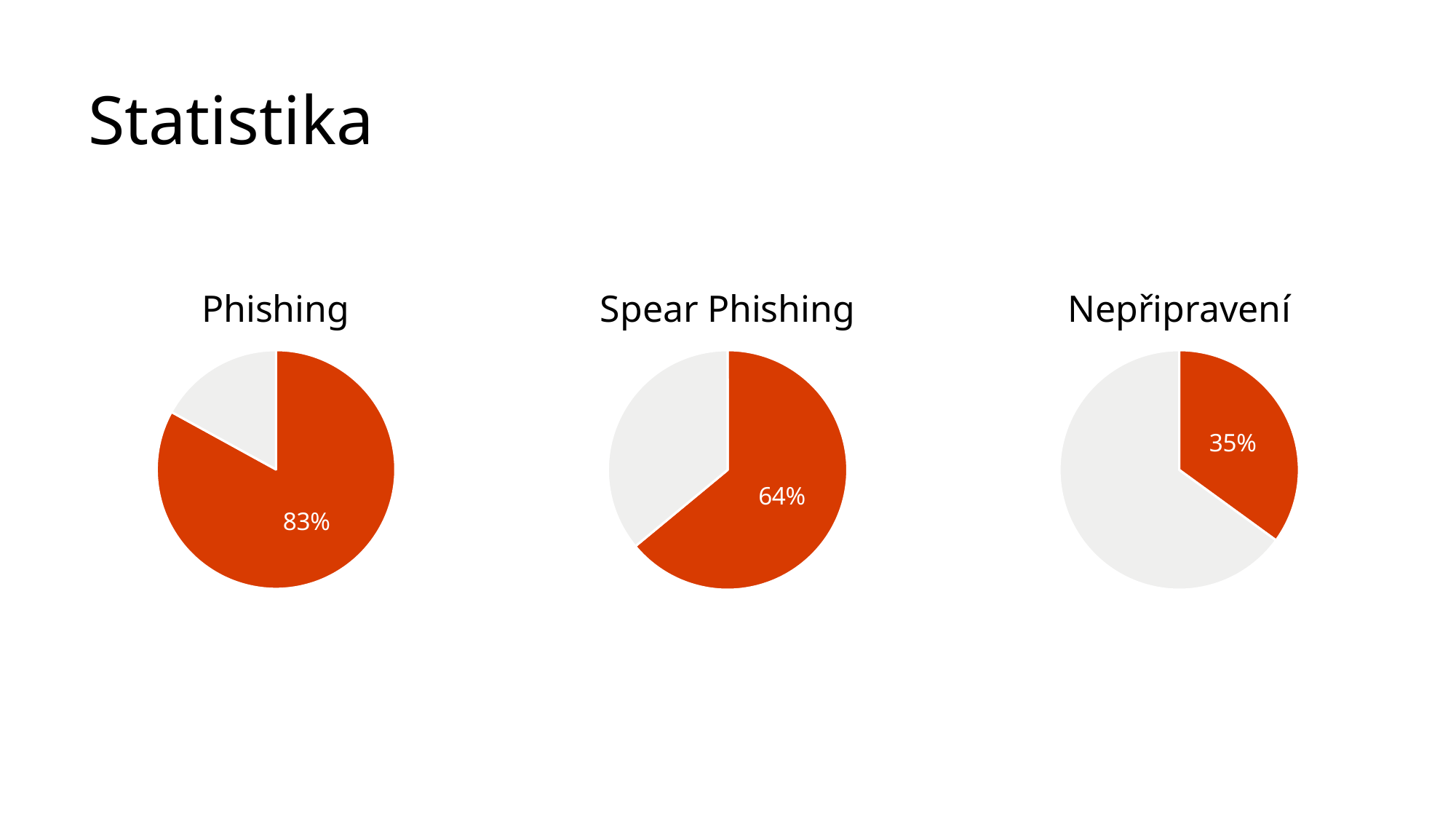
In the Spear Phishing pie chart, what percentage is shown on the orange slice? 64% Which of the three pie charts has the largest labelled orange slice? Phishing What is the difference between the labelled value in the Phishing chart and the labelled value in the Spear Phishing chart? 19% What kind of chart is the Phishing chart? pie chart What is the difference between the labelled value in the Spear Phishing chart and the labelled value in the Nepřipravení chart? 29% In the Phishing pie chart, what percentage is shown on the orange slice? 83% In the Nepřipravení pie chart, what percentage is shown on the orange slice? 35% Which of the three pie charts has the smallest labelled orange slice? Nepřipravení Is the labelled value in the Phishing chart larger or smaller than the labelled value in the Spear Phishing chart? larger How many pie charts are on the slide? 3 What is the title of the pie chart on the right of the slide? Nepřipravení How many slices does the Spear Phishing pie chart have? 2